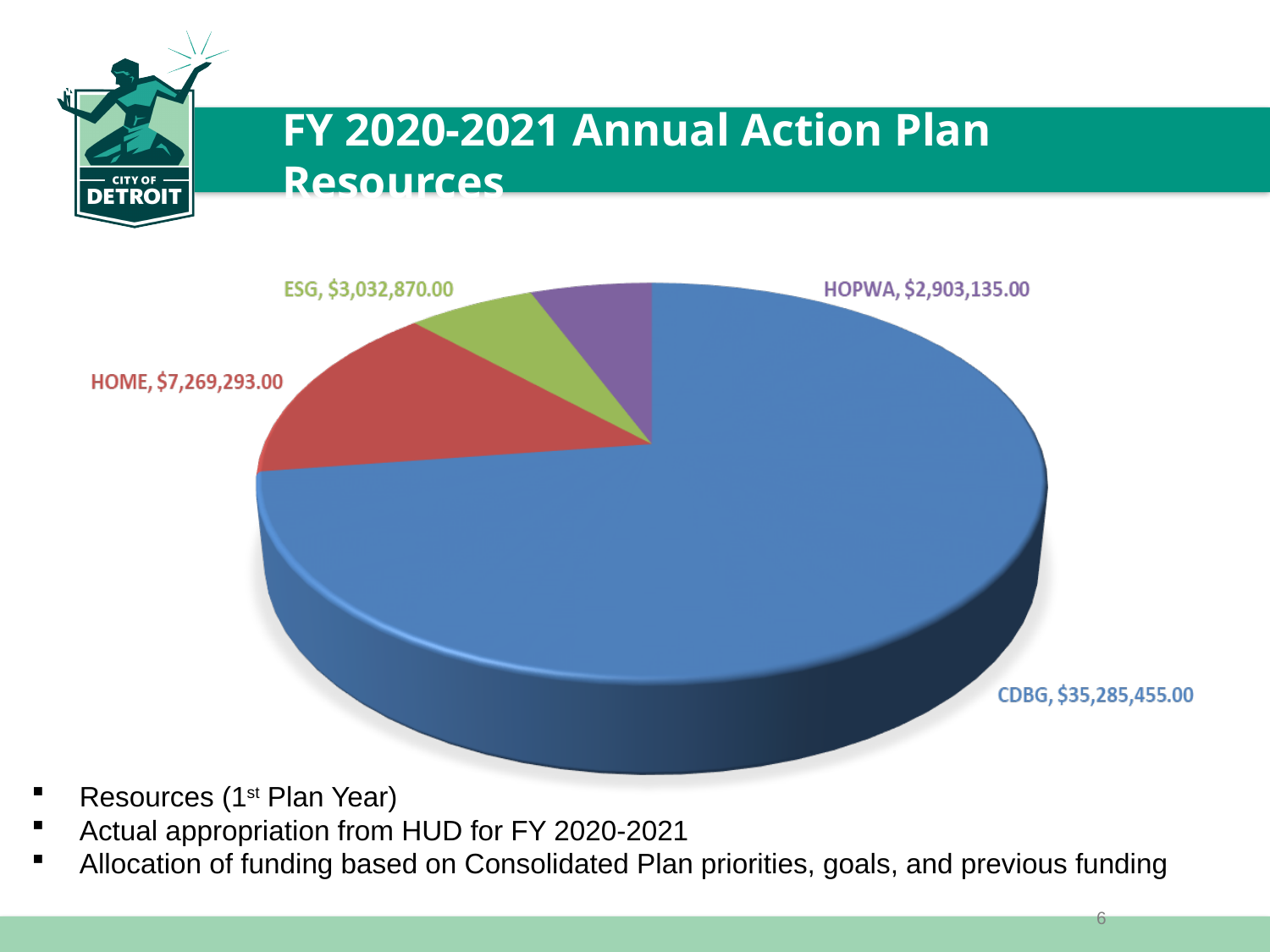
What is the value shown for ESG in the pie chart? $3,032,870.00 Which category has the smallest slice of the pie chart? HOPWA How many categories are shown in the pie chart? 4 What is the value shown for HOME in the pie chart? $7,269,293.00 What is the difference between the ESG and HOPWA values? $129,735.00 What colour is the CDBG slice of the pie chart? Blue What is the value shown for HOPWA in the pie chart? $2,903,135.00 Which category has the largest slice of the pie chart? CDBG Which is larger, the value for HOME or the value for ESG? HOME What is the value shown for CDBG in the pie chart? $35,285,455.00 What kind of chart is shown on the slide? Pie chart What is the difference between the CDBG and HOME values? $28,016,162.00